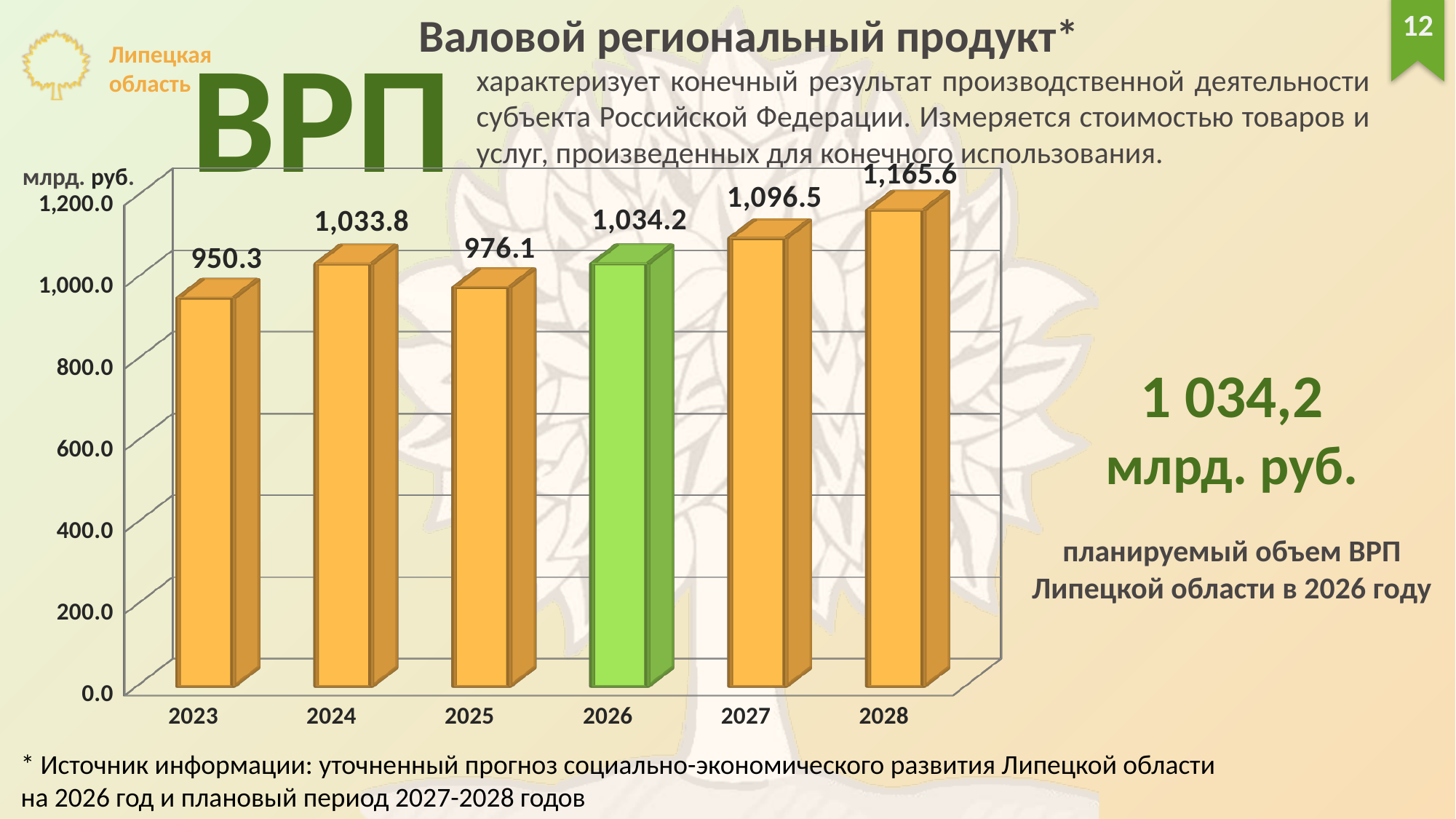
Which year has the highest value? 2028 What is the value for 2026? 1,034.2 What is the value for 2028? 1,165.6 What kind of chart is shown on the slide? bar chart What is the difference between the values for 2028 and 2027? 69.1 Which year's bar is coloured green instead of orange? 2026 Which year has the lowest value? 2023 What is the difference between the values for 2024 and 2023? 83.5 What is the value for 2023? 950.3 Is the value for 2023 greater or less than 1,000.0? less How many years are shown on the x axis? 6 Which is larger, the value for 2025 or the value for 2027? 2027